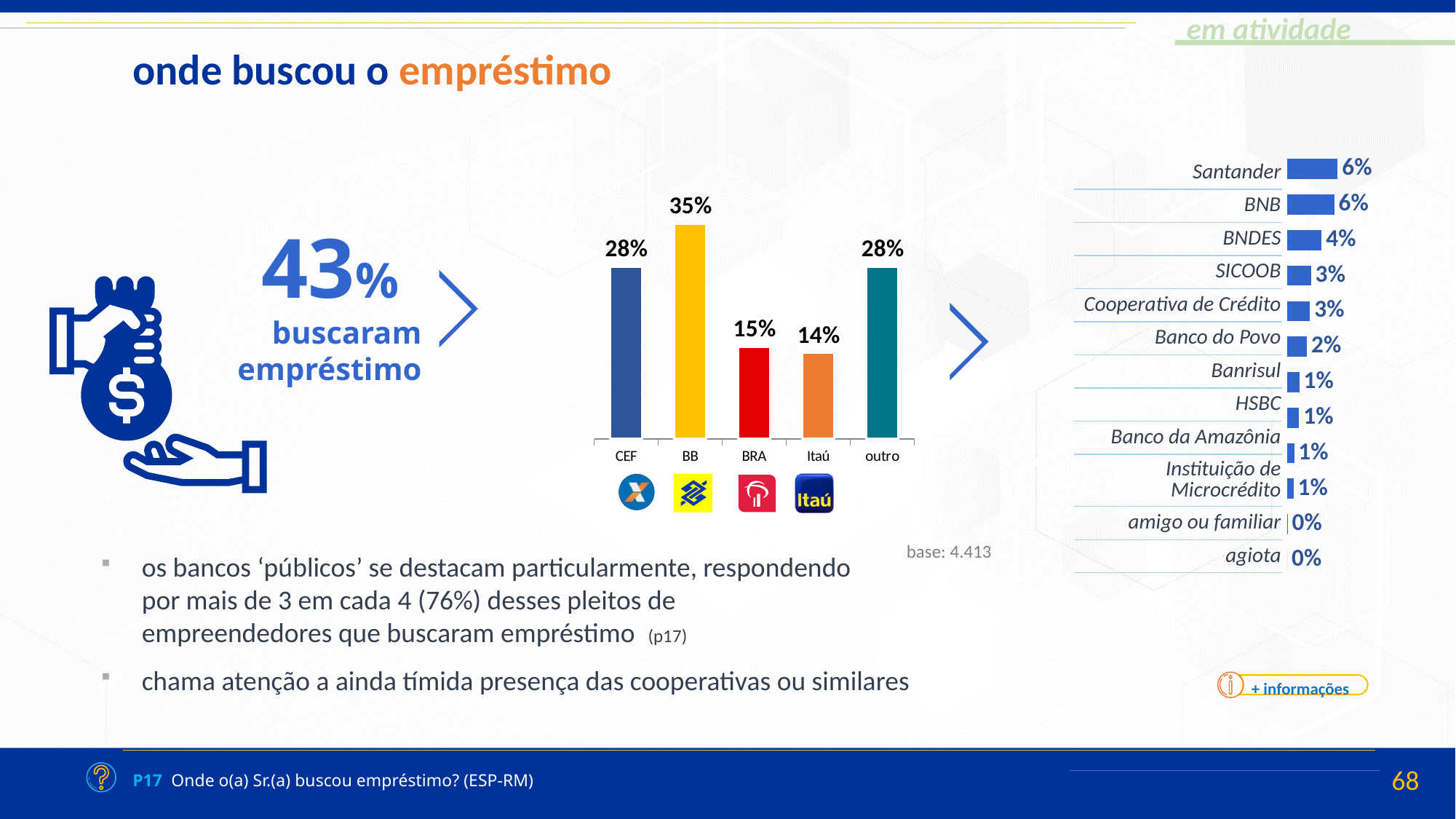
In the middle bar chart, what is the value for Itaú? 14% How many categories are shown in the middle bar chart? 5 In the middle bar chart, what is the difference between the values for BB and BRA? 20% How many categories are shown in the right-hand bar chart? 12 In the right-hand bar chart, what is the value for Banco do Povo? 2% In the middle bar chart, which category has the lowest value? Itaú In the right-hand bar chart, what is the value for BNDES? 4% What kind of chart is the chart in the middle of the slide? bar chart In the right-hand bar chart, what is the difference between the values for Santander and SICOOB? 3% In the middle bar chart, which is larger, the value for CEF or the value for BRA? CEF In the middle bar chart, what is the value for BB? 35% In the middle bar chart, which category has the highest value? BB